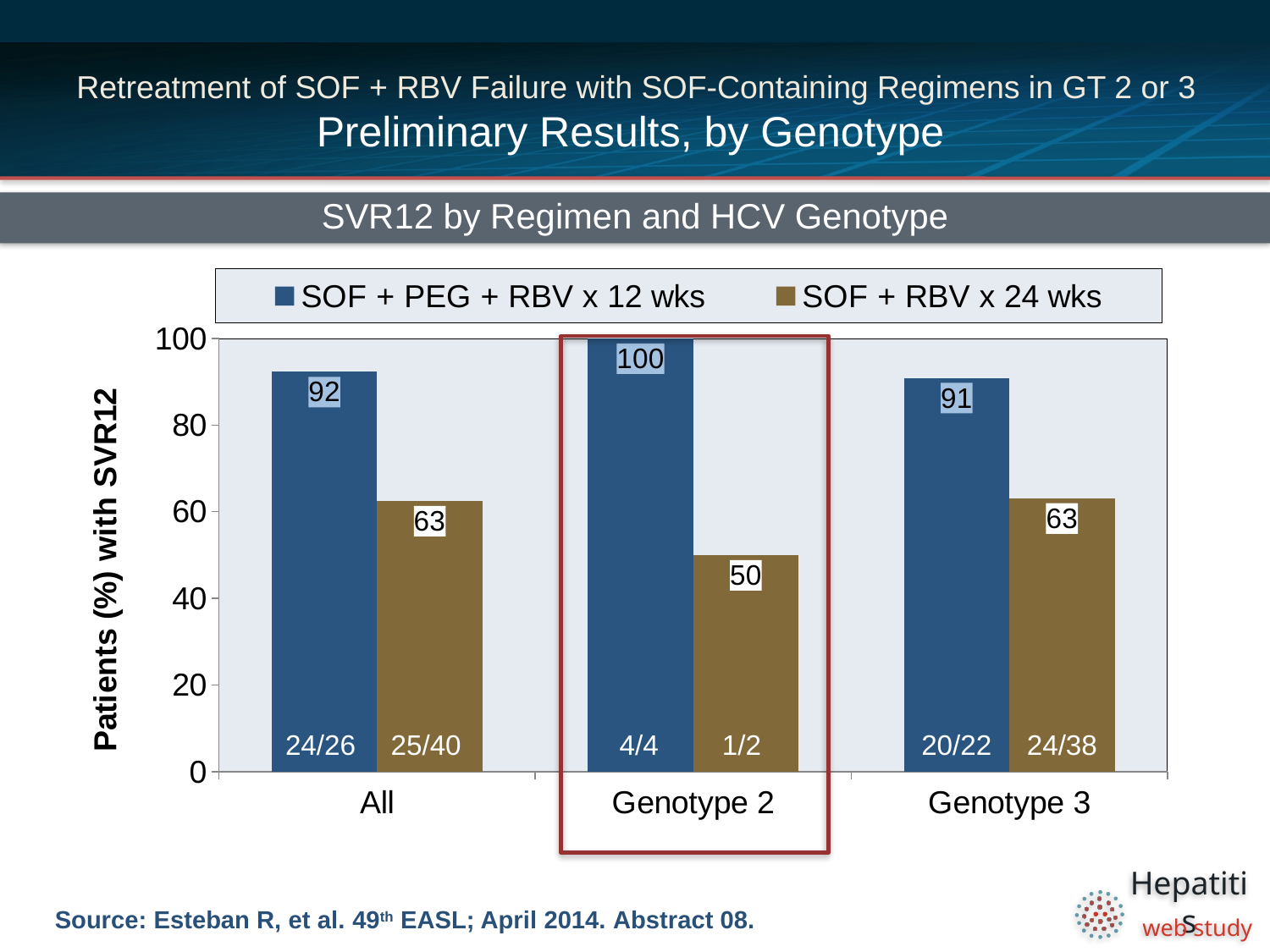
How many series does the legend list? 2 What is the SVR12 value for SOF + PEG + RBV x 12 wks in Genotype 3? 91 What is the SVR12 value for SOF + PEG + RBV x 12 wks in the All group? 92 Which group has the lowest SVR12 value for SOF + RBV x 24 wks? Genotype 2 What kind of chart is shown on the slide? Bar chart In Genotype 3, which regimen has the higher SVR12 value? SOF + PEG + RBV x 12 wks What is the difference between the two regimens' SVR12 values in the All group? 29 Which genotype group has the highest SVR12 value for SOF + PEG + RBV x 12 wks? Genotype 2 What is the difference between the SOF + PEG + RBV x 12 wks and SOF + RBV x 24 wks values in Genotype 2? 50 How many genotype groups are shown on the x axis? 3 What is the SVR12 value for SOF + RBV x 24 wks in Genotype 2? 50 What fraction of patients is shown for SOF + RBV x 24 wks in Genotype 3? 24/38